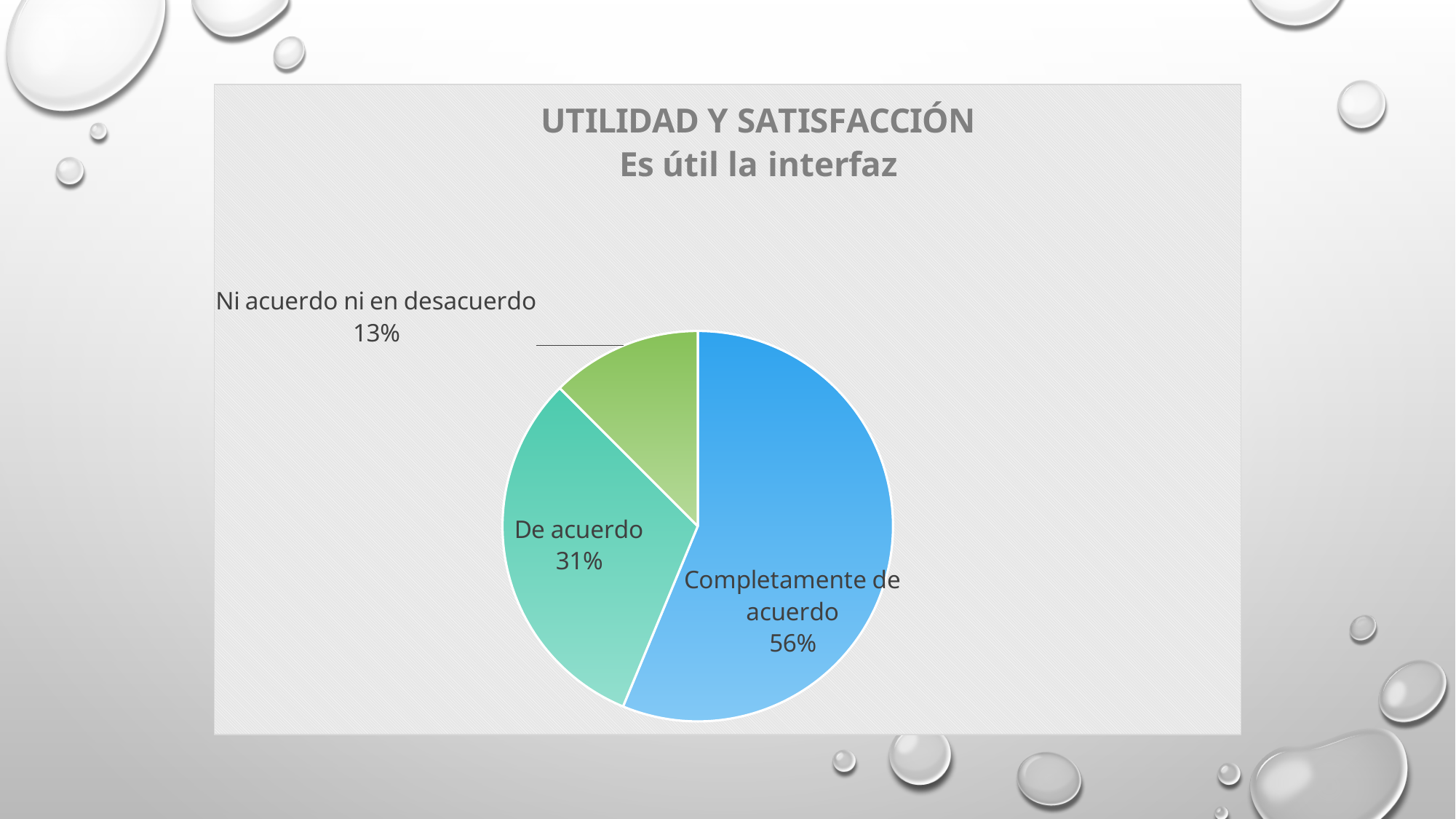
What is the difference in percentage points between 'Completamente de acuerdo' and 'De acuerdo'? 25 What is the title of the chart? UTILIDAD Y SATISFACCIÓN Es útil la interfaz What kind of chart is shown on the slide? pie chart Which category has the smallest share of the pie? Ni acuerdo ni en desacuerdo What percentage of the pie is 'Ni acuerdo ni en desacuerdo'? 13% What percentage of the pie is 'Completamente de acuerdo'? 56% Which is larger, the share for 'De acuerdo' or the share for 'Ni acuerdo ni en desacuerdo'? De acuerdo What colour is the 'Completamente de acuerdo' slice? blue What percentage of the pie is 'De acuerdo'? 31% What is the difference in percentage points between 'De acuerdo' and 'Ni acuerdo ni en desacuerdo'? 18 Which category has the largest share of the pie? Completamente de acuerdo How many slices does the pie chart have? 3